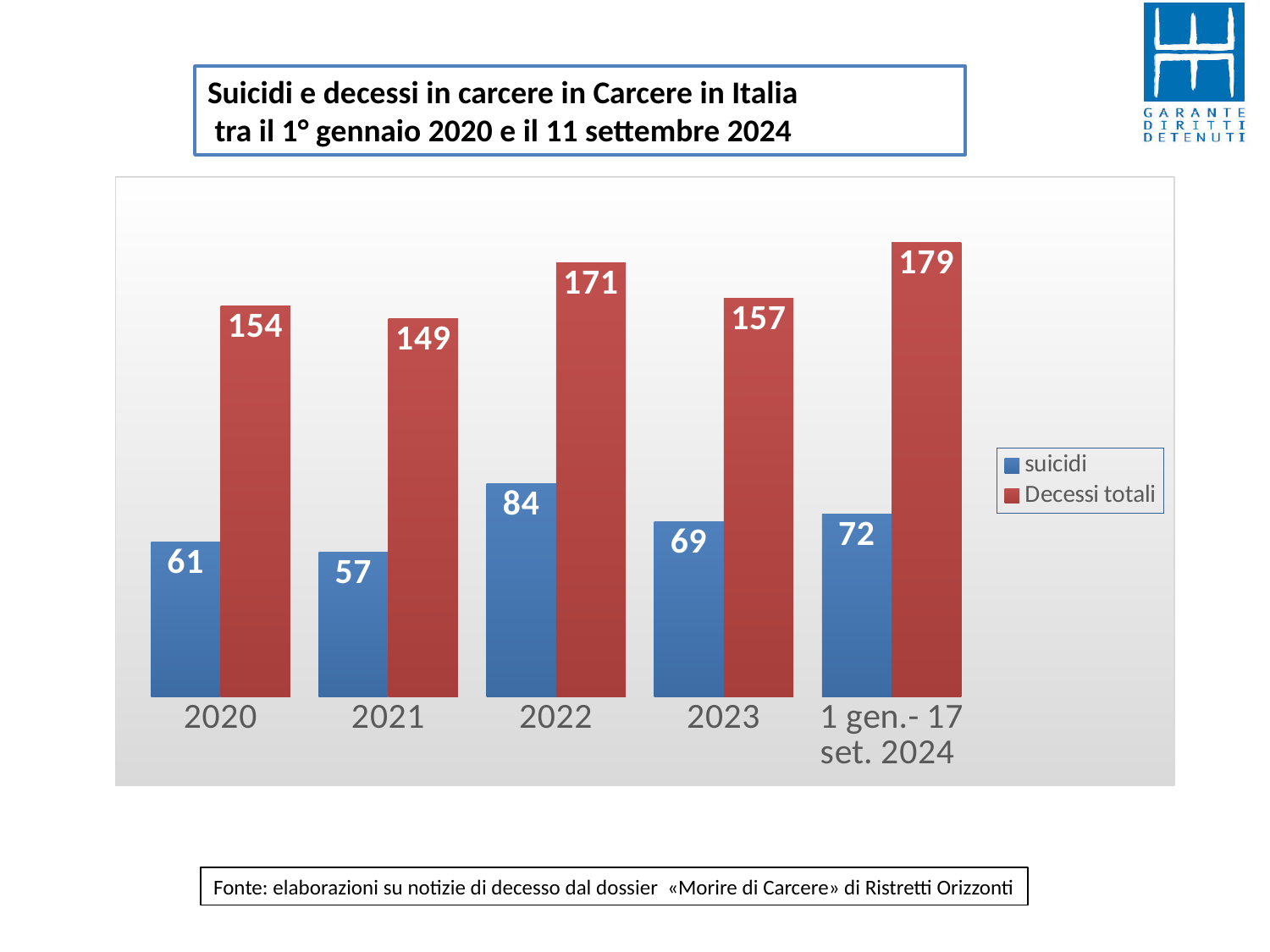
Which category has the lowest value for suicidi? 2021 What is the value for Decessi totali in the period 1 gen.- 17 set. 2024? 179 How many series does the legend list? 2 Which is larger: Decessi totali in 2022 or Decessi totali in 2023? 2022 What kind of chart is shown on the slide? bar chart What colour are the bars for the suicidi series? blue What is the value for Decessi totali in 2021? 149 How many categories are shown on the x axis? 5 What is the value for suicidi in 2022? 84 What is the difference between Decessi totali and suicidi in 2020? 93 Which category has the highest value for Decessi totali? 1 gen.- 17 set. 2024 What is the difference between the suicidi values for 2022 and 2023? 15